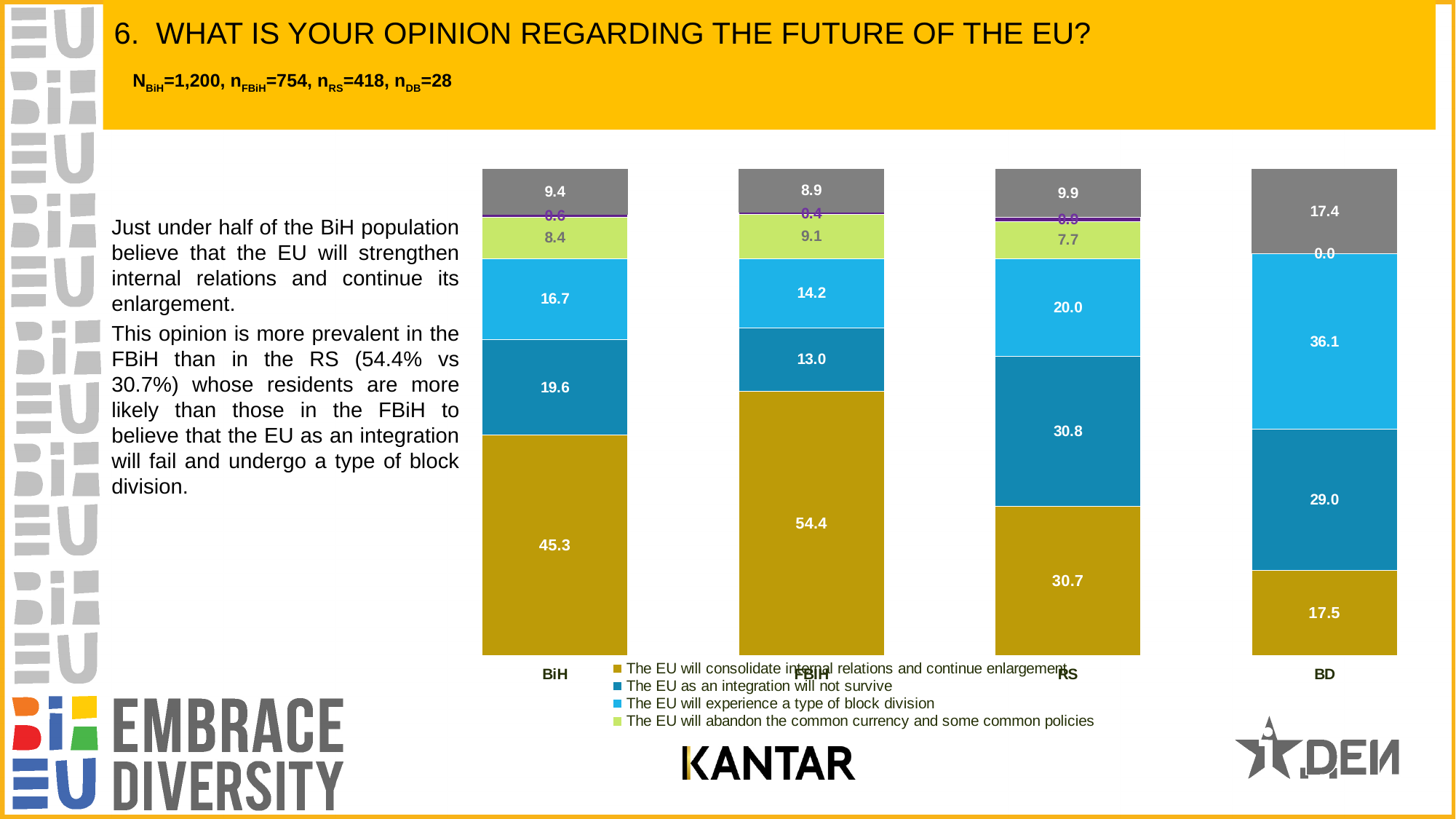
What is the difference between the FBiH and RS values for 'The EU will consolidate internal relations and continue enlargement'? 23.7 How many series does the visible legend list? 4 What is the value for 'The EU will abandon the common currency and some common policies' for BiH? 8.4 What is the value for 'The EU will experience a type of block division' for BD? 36.1 How many categories (regions) are shown on the x axis of the chart? 4 What is the value for 'The EU will consolidate internal relations and continue enlargement' for FBiH? 54.4 Which is larger: the value for 'The EU as an integration will not survive' in BiH or in FBiH? BiH Which region has the highest value for 'The EU will consolidate internal relations and continue enlargement'? FBiH What kind of chart is shown on the slide? stacked bar chart What is the value for 'The EU as an integration will not survive' for RS? 30.8 Which region has the lowest value for 'The EU will consolidate internal relations and continue enlargement'? BD Which colour represents 'The EU will experience a type of block division' in the chart? light blue